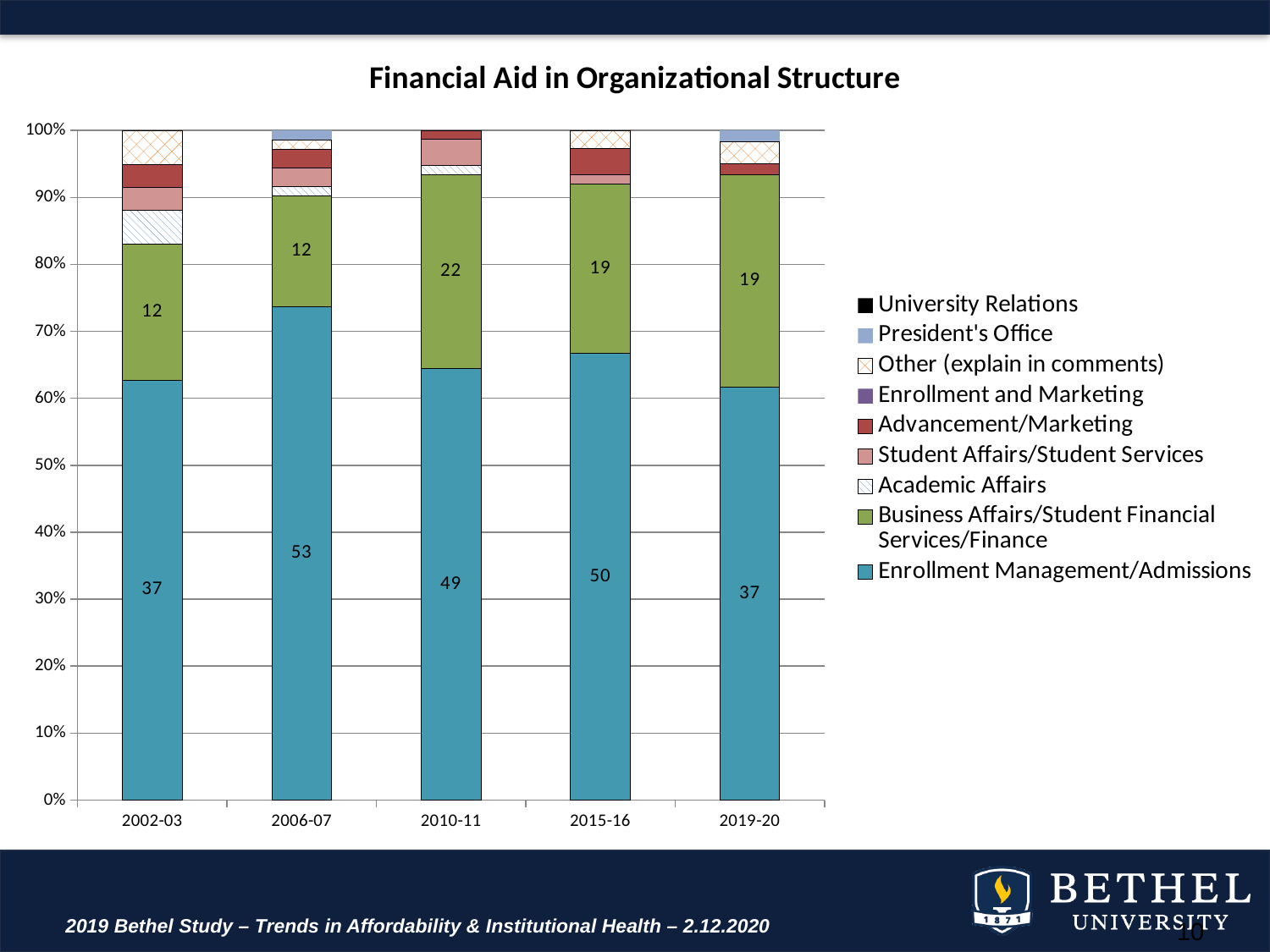
What type of chart is shown on the slide? Stacked bar chart In which year does Business Affairs/Student Financial Services/Finance have the highest labelled value? 2010-11 What is the difference between the Enrollment Management/Admissions labels for 2006-07 and 2002-03? 16 What is the data label for Business Affairs/Student Financial Services/Finance in 2010-11? 22 Is the Enrollment Management/Admissions share of the 2019-20 bar greater or less than 70%? less What is the data label for Enrollment Management/Admissions in 2019-20? 37 How many years are shown on the x axis? 5 Which year has the larger Enrollment Management/Admissions label, 2006-07 or 2010-11? 2006-07 Is the Enrollment Management/Admissions share of the 2006-07 bar greater or less than 70%? greater In which year does Enrollment Management/Admissions have the highest labelled value? 2006-07 What is the data label for Enrollment Management/Admissions in 2006-07? 53 How many series does the legend list? 9